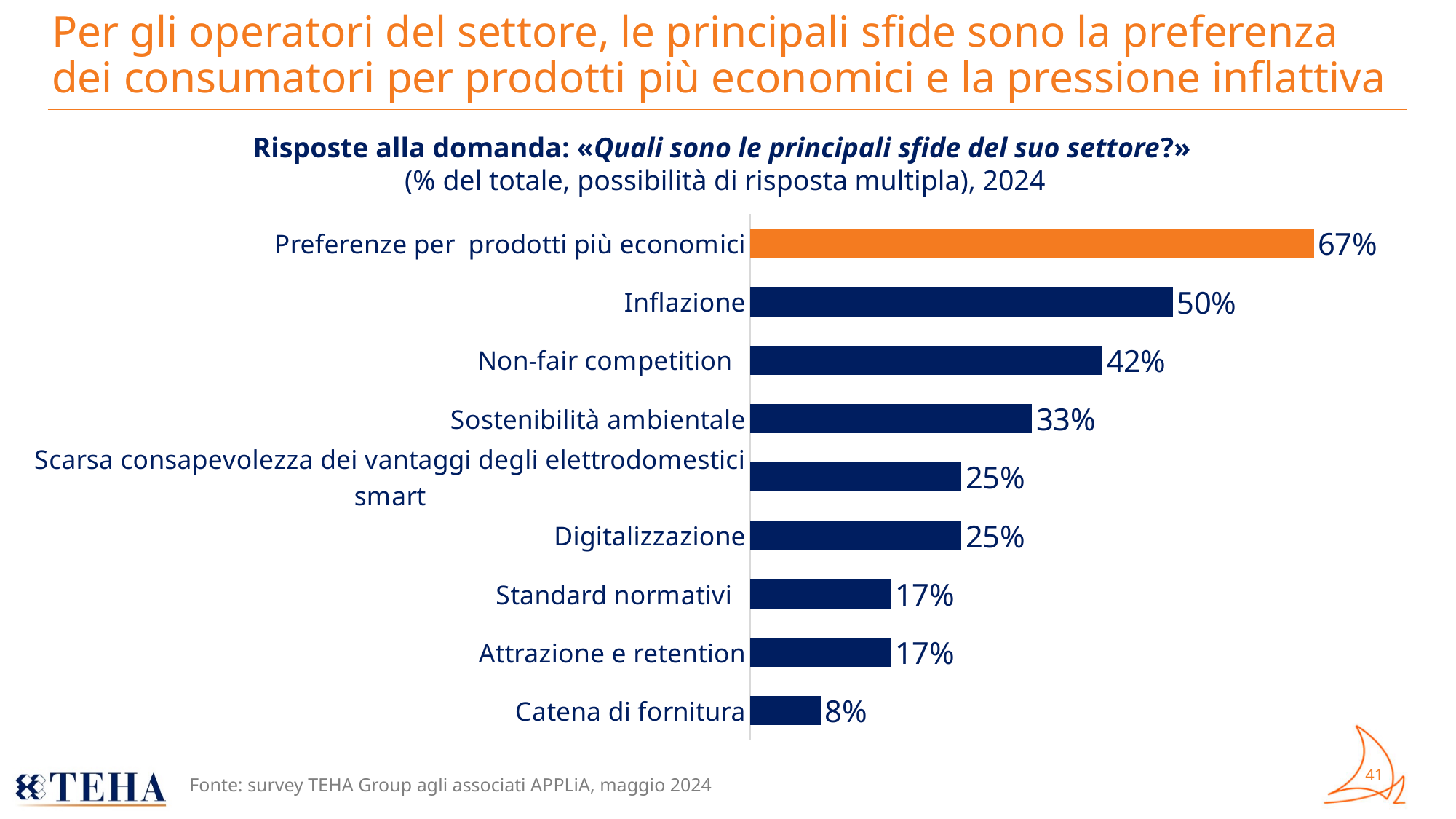
Which bar is highlighted in orange? Preferenze per prodotti più economici What kind of chart is shown on the slide? Bar chart What is the difference between the values for Digitalizzazione and Standard normativi? 8% Which is larger, the value for Non-fair competition or the value for Sostenibilità ambientale? Non-fair competition Which category has the highest value? Preferenze per prodotti più economici How many categories are shown in the chart? 9 What is the value for Sostenibilità ambientale? 33% What is the difference between the values for Preferenze per prodotti più economici and Inflazione? 17% Which category has the lowest value? Catena di fornitura What is the value for Non-fair competition? 42% What is the value for Inflazione? 50% What is the value for Catena di fornitura? 8%